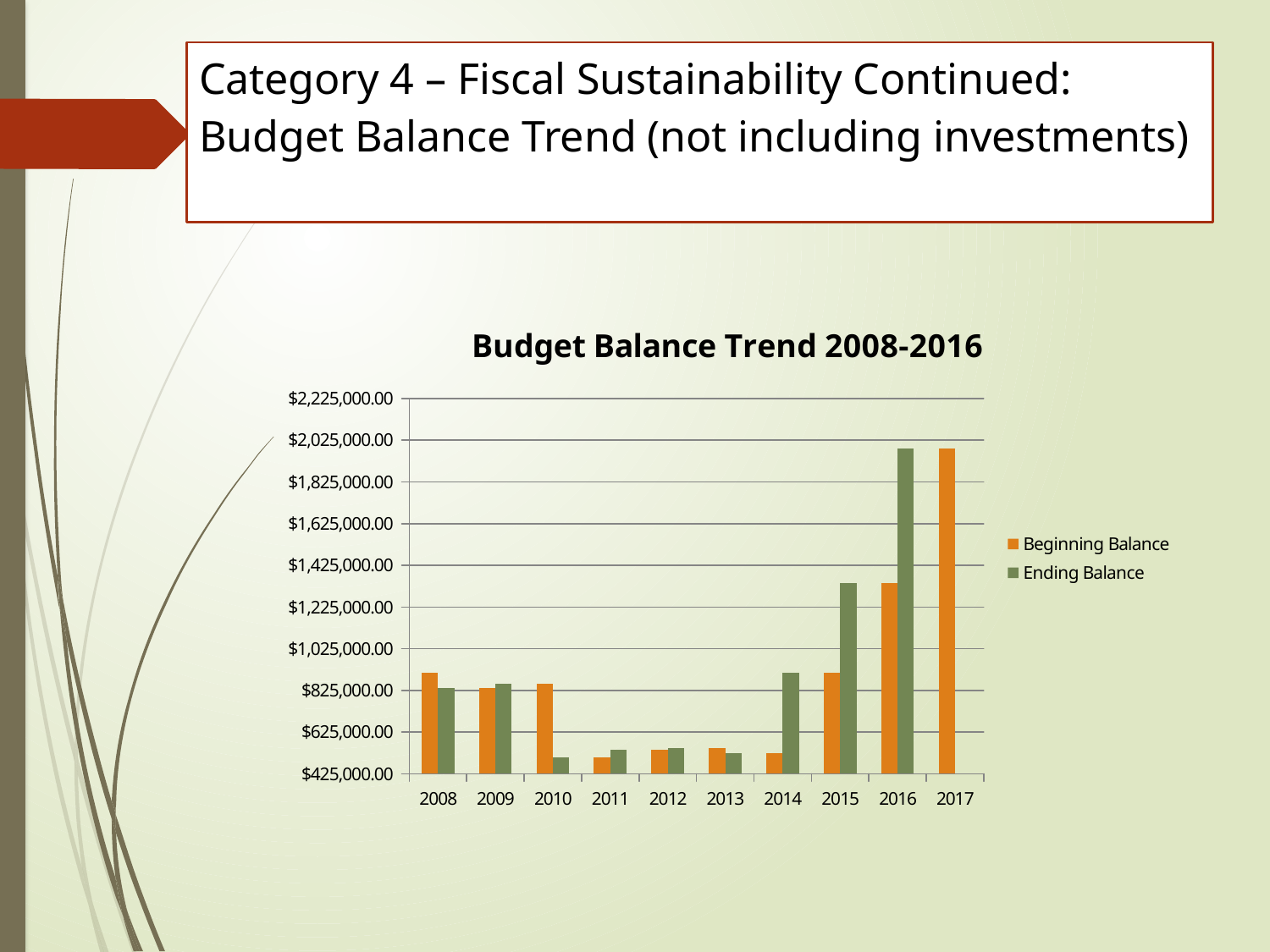
What type of chart is shown on the slide? Bar chart Which year has the highest Ending Balance? 2016 Does the Ending Balance rise or fall from 2014 to 2016? Rise Is the Beginning Balance for 2011 greater or less than $625,000.00? less Is the Ending Balance for 2015 greater or less than $1,225,000.00? greater In 2014, which is larger, the Beginning Balance or the Ending Balance? Ending Balance How many series does the legend list? 2 What is the title of the chart? Budget Balance Trend 2008-2016 How many years are shown on the x axis of the chart? 10 Which year has the highest Beginning Balance? 2017 In 2010, which is larger, the Beginning Balance or the Ending Balance? Beginning Balance Is the Ending Balance for 2016 greater or less than $1,825,000.00? greater